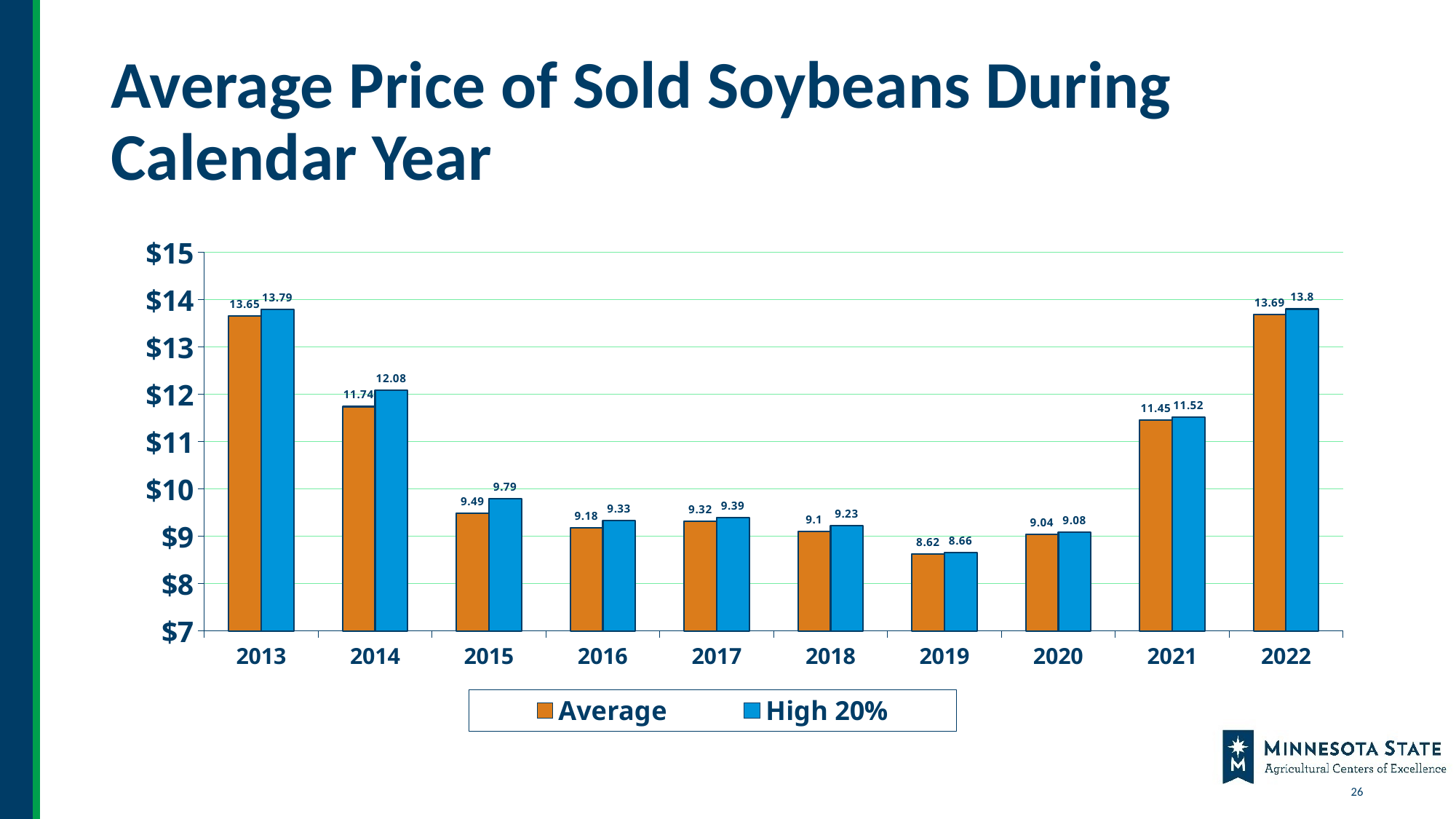
What is the Average price for 2015? 9.49 How many series does the legend list? 2 Which is larger, the Average price in 2017 or the Average price in 2016? 2017 What is the High 20% price for 2014? 12.08 What kind of chart is shown on the slide? Bar chart Which year has the lowest Average price? 2019 Which year has the highest High 20% price? 2022 How many years are shown on the x axis? 10 Is the Average value for 2021 greater or less than $11? greater Do the Average prices rise or fall from 2013 to 2016? Fall What is the High 20% value for 2022? 13.8 What is the difference between the High 20% and Average values in 2014? 0.34